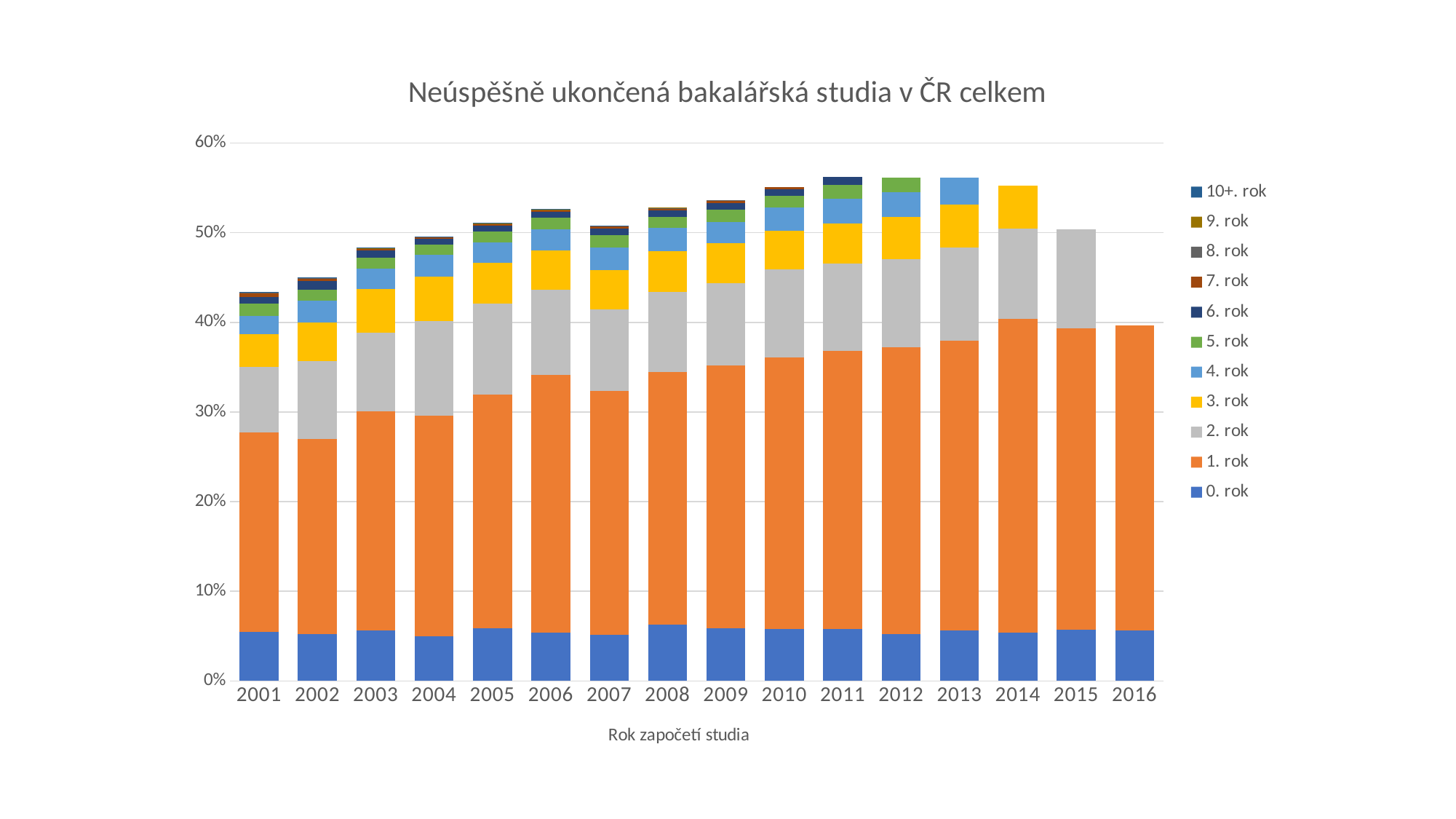
Is the total stacked bar for 2014 larger or smaller than the total for 2016? larger Is the total stacked value for 2014 greater or less than 50%? greater How many years (categories) are shown on the x axis? 16 Which year has the lowest total stacked bar? 2016 What kind of chart is shown on the slide? Stacked bar chart Do the total stacked bar heights rise or fall from 2013 to 2016? fall Is the total stacked value for 2016 greater or less than 50%? less What is the label of the x axis? Rok započetí studia What is the title of the chart? Neúspěšně ukončená bakalářská studia v ČR celkem How many series does the legend list? 11 Is the total stacked value for 2001 greater or less than 40%? greater Do the total stacked bar heights rise or fall from 2001 to 2011? rise